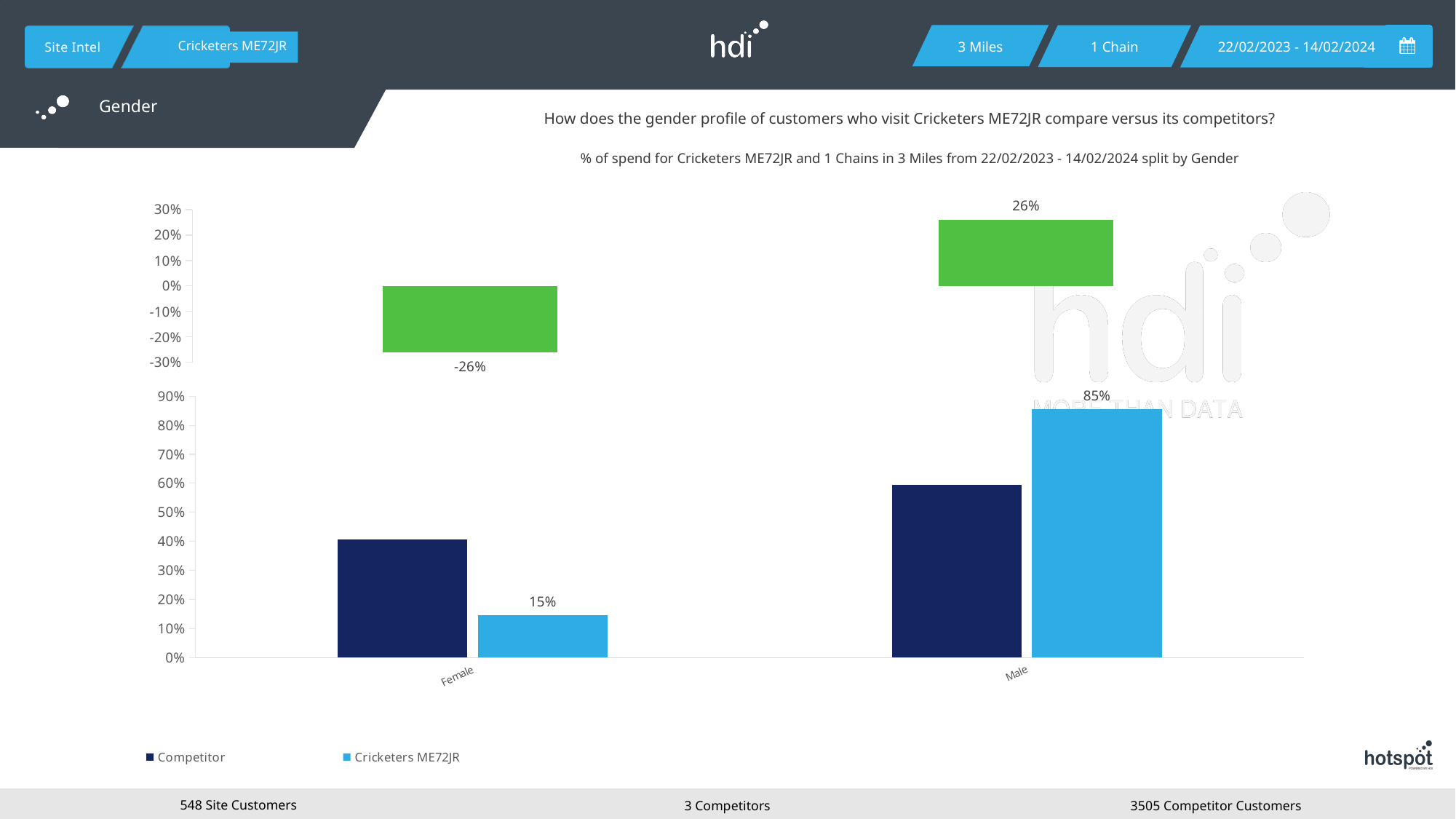
In the top chart, what is the value shown for the Male category? 26% In the bottom chart, what is the value for Cricketers ME72JR in the Male category? 85% In the bottom chart, which is larger for the Male category: Competitor or Cricketers ME72JR? Cricketers ME72JR In the bottom chart, is the Competitor value for Male greater or less than 50%? greater How many series does the legend of the bottom chart list? 2 In the bottom chart, which is larger for the Female category: Competitor or Cricketers ME72JR? Competitor In the bottom chart, is the Competitor value for Female greater or less than 50%? less How many categories are shown on the x axis of the bottom chart? 2 In the top chart, what is the value shown for the Female category? -26% What kind of chart is the bottom chart? Bar chart In the bottom chart, what is the difference between the Cricketers ME72JR values for Male and Female? 70% In the bottom chart, what is the value for Cricketers ME72JR in the Female category? 15%